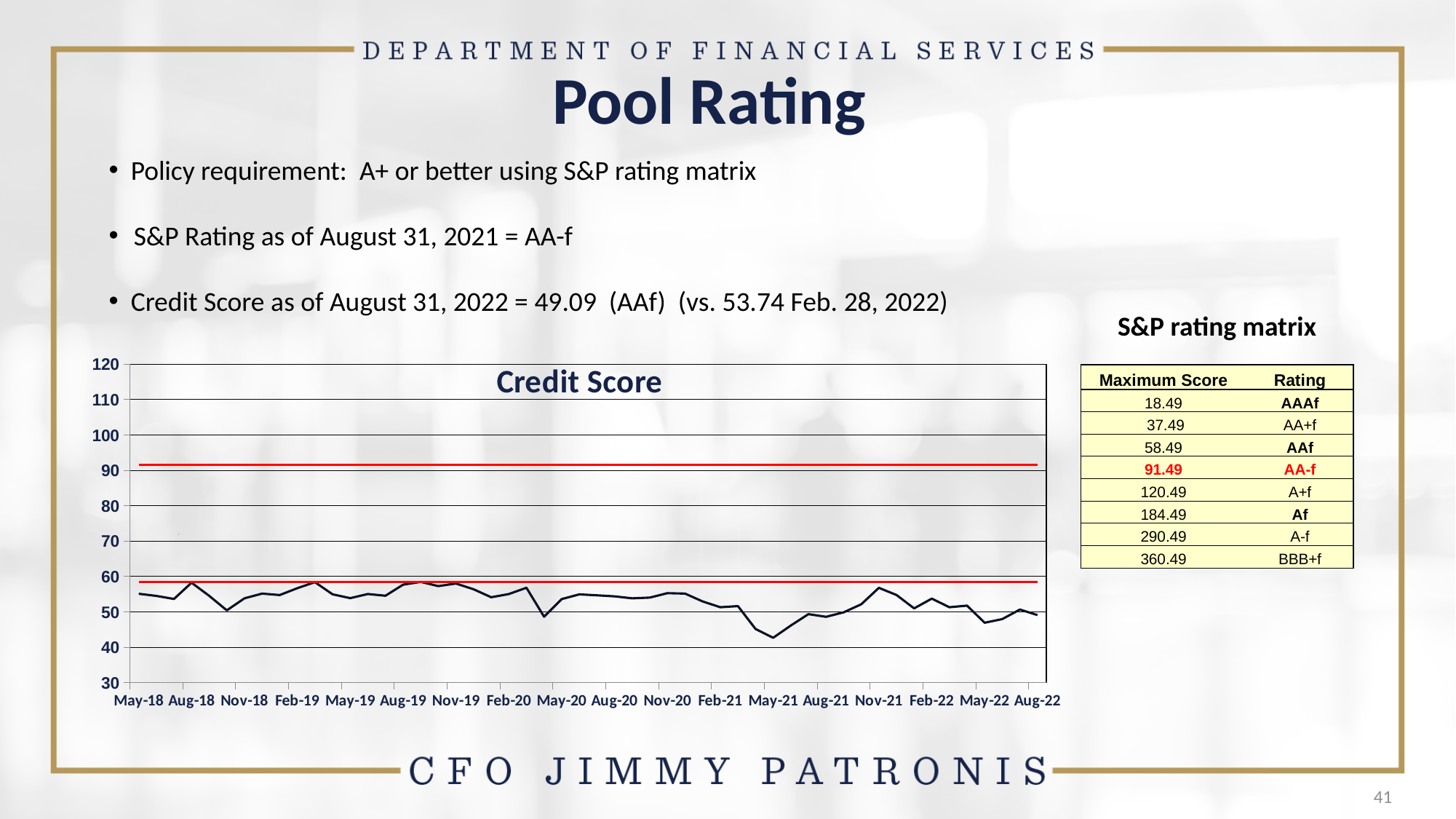
How many date labels are shown along the x axis of the Credit Score chart? 18 Which has the higher credit score on the chart, May-21 or Nov-21? Nov-21 Is the credit score for Nov-21 greater or less than 50? greater Is the credit score for Aug-22 greater or less than 60? less Which x-axis date has the lowest credit score on the chart? May-21 How many red horizontal lines are drawn on the Credit Score chart? 2 What is the title of the chart on the slide? Credit Score Is the credit score for Feb-22 greater or less than 50? greater Between Feb-21 and May-21, does the credit score line rise or fall? fall What kind of chart is the Credit Score chart? line chart